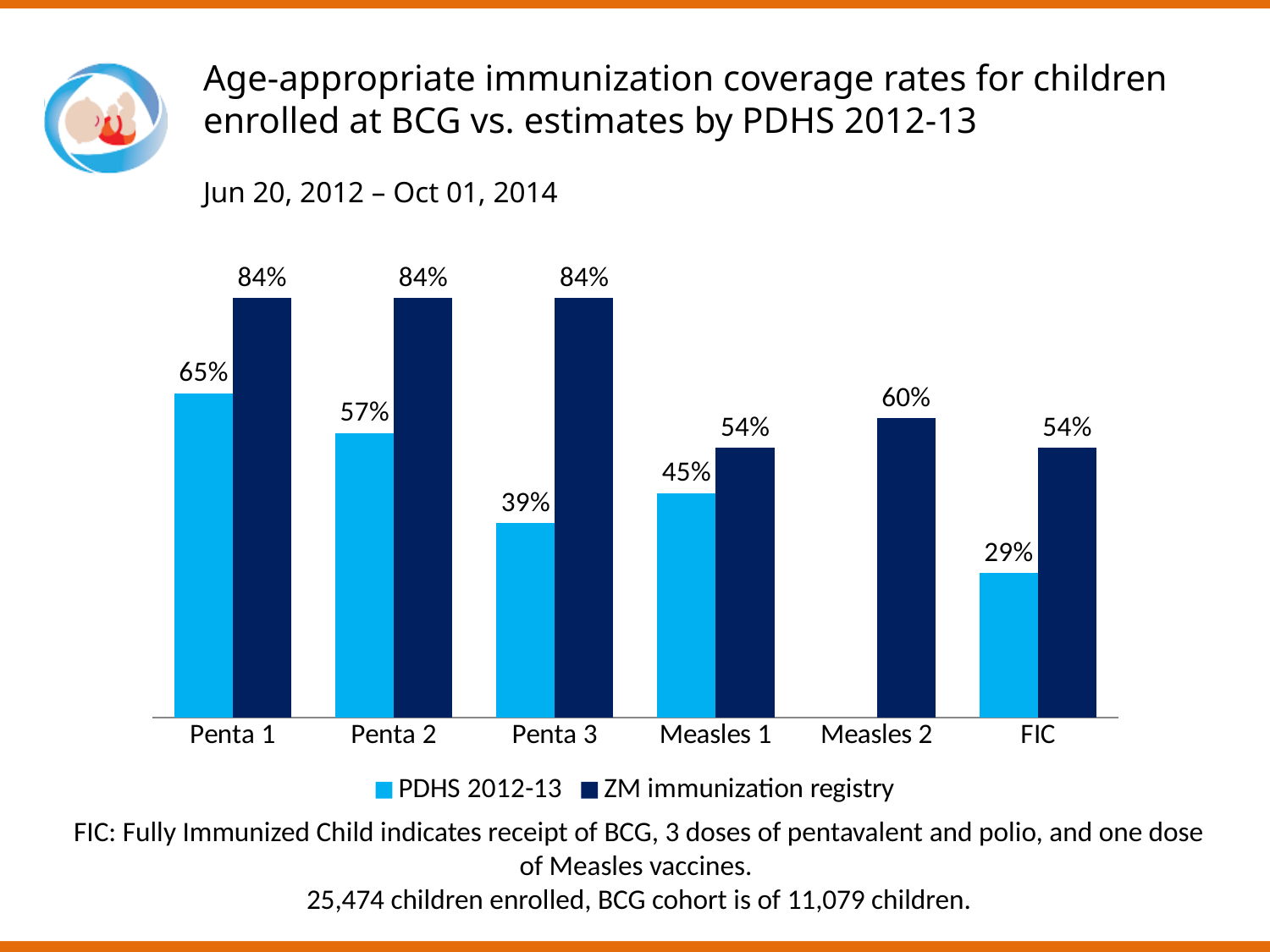
Which is larger for Measles 1: the PDHS 2012-13 value or the ZM immunization registry value? ZM immunization registry How many series does the legend list? 2 What is the PDHS 2012-13 value for FIC? 29% What is the ZM immunization registry value for Measles 2? 60% Which category has the lowest ZM immunization registry value? Measles 1 and FIC (both 54%) Which category has no PDHS 2012-13 bar? Measles 2 How many categories are shown on the x axis? 6 What is the PDHS 2012-13 value for Penta 1? 65% Which category has the lowest PDHS 2012-13 value? FIC What is the difference between the ZM immunization registry and PDHS 2012-13 values for Penta 3? 45% What kind of chart is shown on the slide? Bar chart Do the PDHS 2012-13 values rise or fall from Penta 1 to Penta 3? Fall